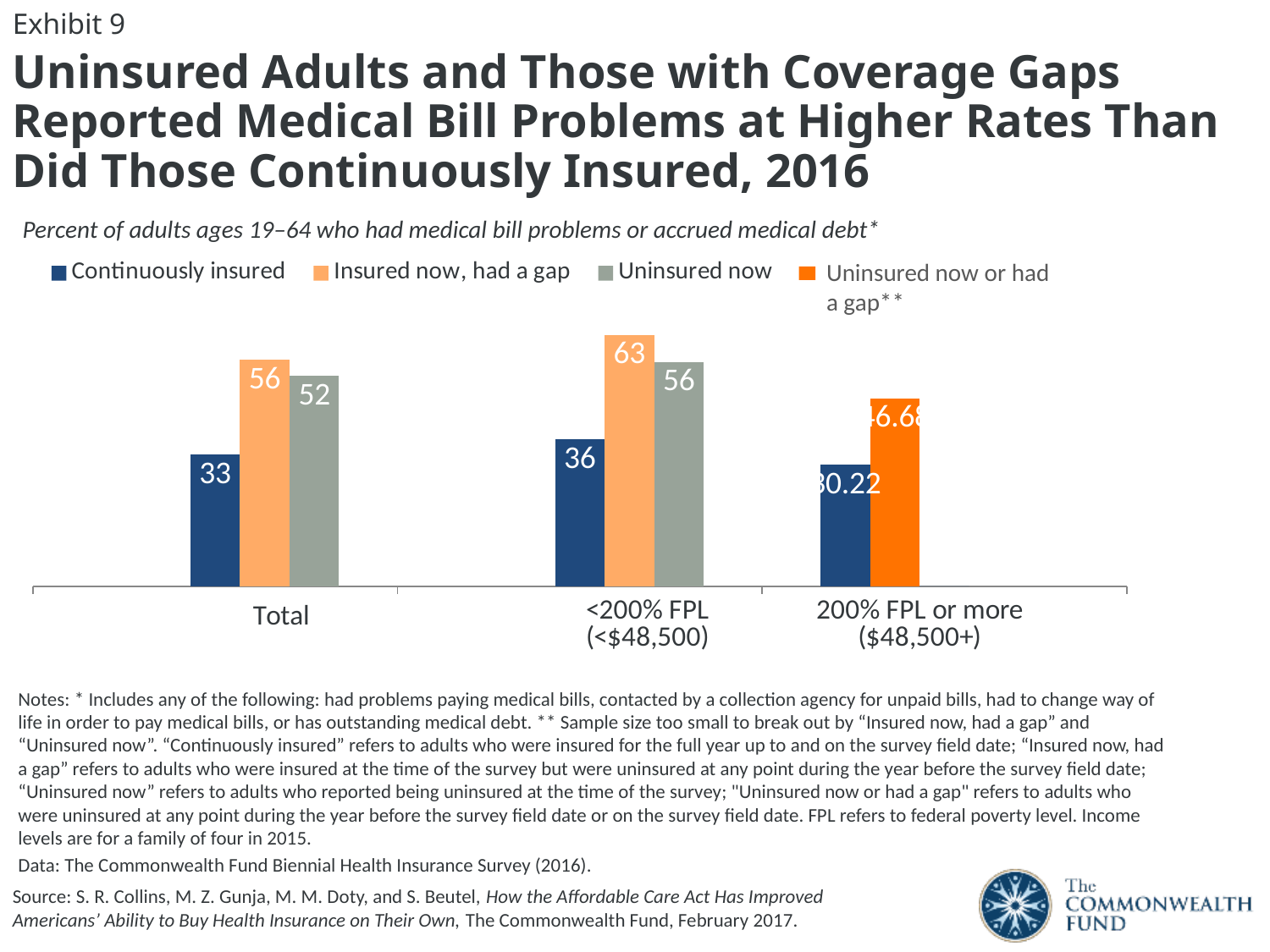
What is the value for Continuously insured in the Total category? 33 In the <200% FPL (<$48,500) category, which series has the lowest value? Continuously insured For Continuously insured, which category has the larger value: Total or <200% FPL (<$48,500)? <200% FPL (<$48,500) In the Total category, which series has the highest value? Insured now, had a gap What is the value for Uninsured now in the <200% FPL (<$48,500) category? 56 How many categories are shown on the x axis? 3 In the <200% FPL (<$48,500) category, what is the difference between Insured now, had a gap and Uninsured now? 7 What kind of chart is shown on the slide? Bar chart What is the value for Insured now, had a gap in the Total category? 56 How many series does the legend list? 4 What is the value for Insured now, had a gap in the <200% FPL (<$48,500) category? 63 In the Total category, what is the difference between Insured now, had a gap and Continuously insured? 23